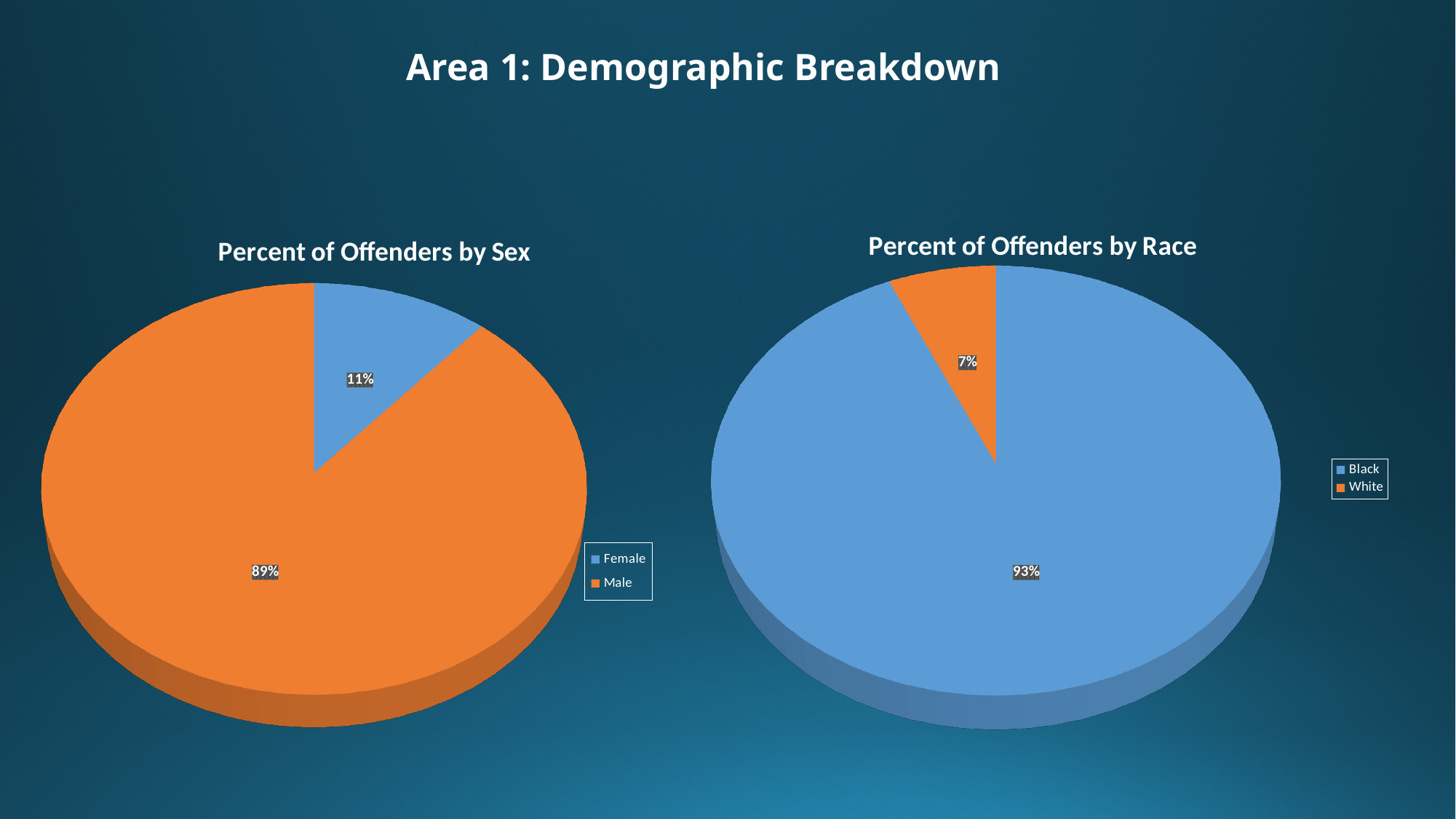
In the 'Percent of Offenders by Sex' chart, which category has the largest share? Male In the 'Percent of Offenders by Race' chart, what colour represents the Black category? Blue In the 'Percent of Offenders by Race' chart, which category has the smallest share? White What type of chart is 'Percent of Offenders by Race'? Pie chart In the 'Percent of Offenders by Sex' chart, what percentage of offenders are Male? 89% In the 'Percent of Offenders by Race' chart, what percentage of offenders are White? 7% In the 'Percent of Offenders by Race' chart, what percentage of offenders are Black? 93% How many categories does the 'Percent of Offenders by Sex' chart show? 2 In the 'Percent of Offenders by Sex' chart, what percentage of offenders are Female? 11% In the 'Percent of Offenders by Sex' chart, what is the difference between the Male and Female percentages? 78% In the 'Percent of Offenders by Race' chart, what is the difference between the Black and White percentages? 86% Which is larger: the Female share in the 'Percent of Offenders by Sex' chart or the White share in the 'Percent of Offenders by Race' chart? Female share